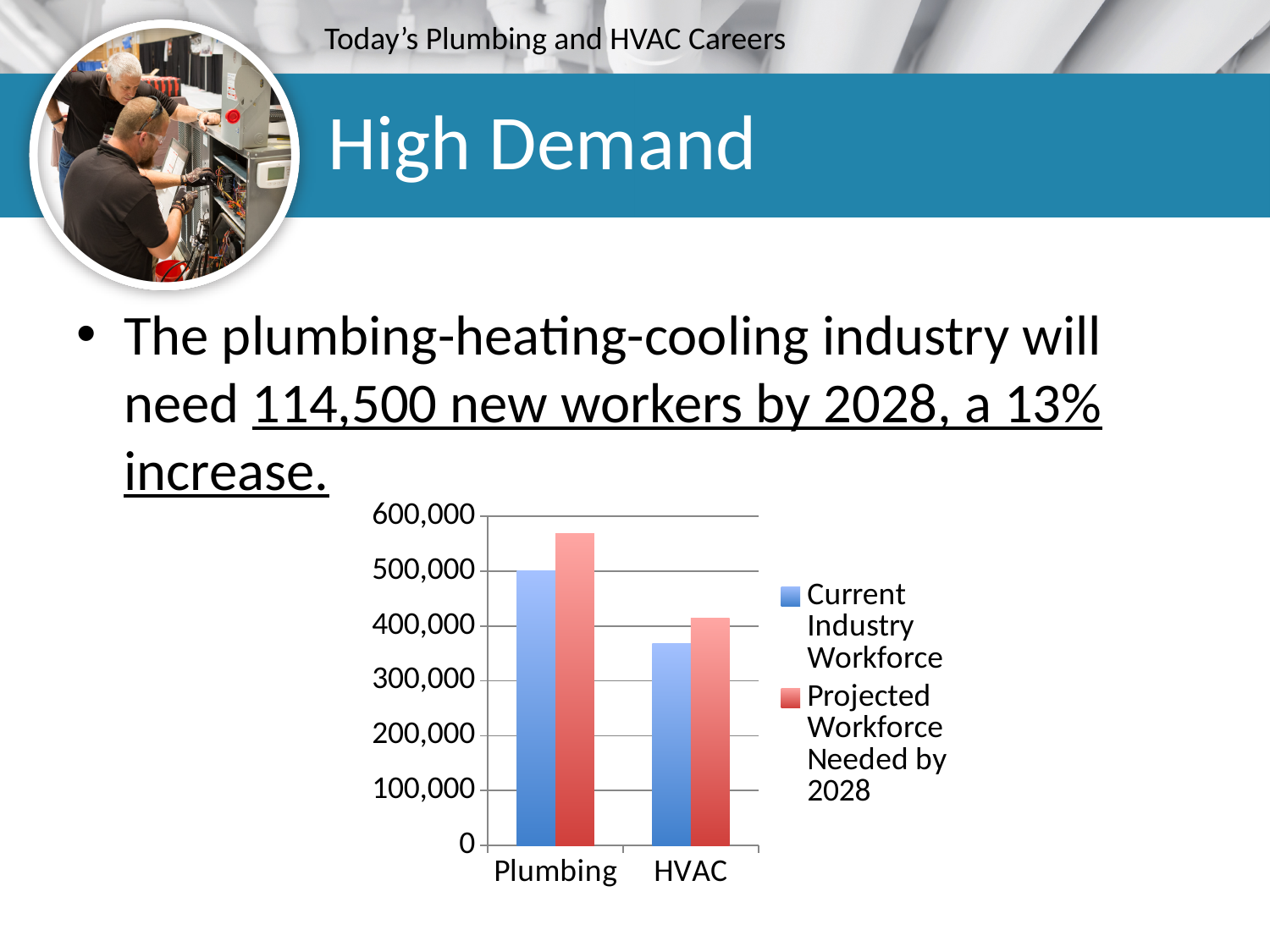
How many categories are shown on the x axis of the chart? 2 Which series is shown in red in the chart? Projected Workforce Needed by 2028 Which category has the highest Projected Workforce Needed by 2028? Plumbing How many series does the chart's legend list? 2 For HVAC, is the Current Industry Workforce or the Projected Workforce Needed by 2028 larger? Projected Workforce Needed by 2028 Which category has the lowest Current Industry Workforce? HVAC What are the two categories labelled on the x axis of the chart? Plumbing and HVAC What kind of chart is shown on the slide? bar chart Is the Projected Workforce Needed by 2028 for HVAC greater or less than 500,000? less Is the Projected Workforce Needed by 2028 for Plumbing greater or less than 500,000? greater Is the Current Industry Workforce larger for Plumbing or for HVAC? Plumbing Is the Current Industry Workforce for HVAC greater or less than 400,000? less